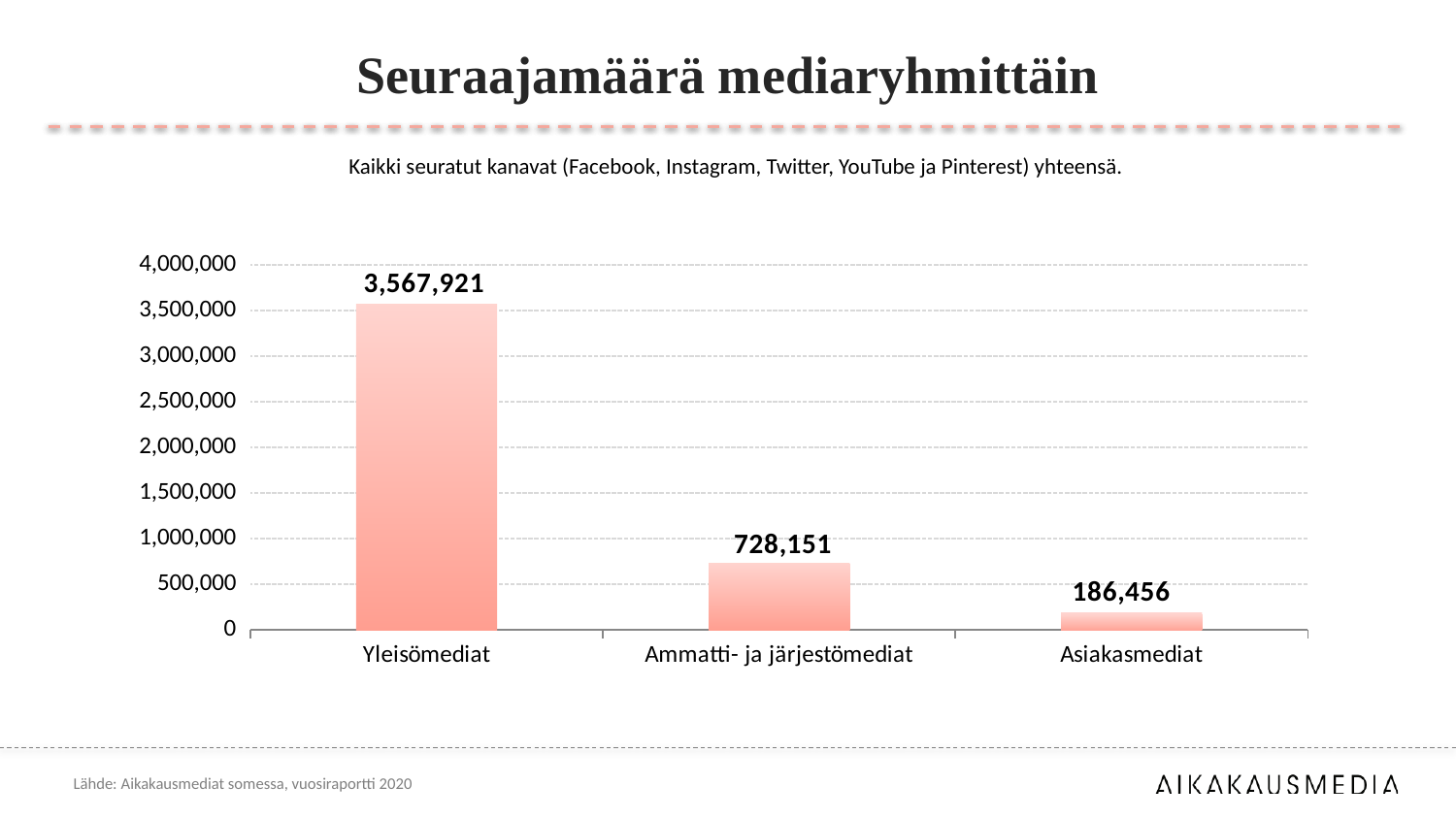
What is the title of the chart? Seuraajamäärä mediaryhmittäin What is the value for Yleisömediat? 3,567,921 What is the difference between the values for Ammatti- ja järjestömediat and Asiakasmediat? 541,695 What kind of chart is shown on the slide? bar chart How many categories are shown on the x axis? 3 Is the value for Ammatti- ja järjestömediat greater or less than 1,000,000? less Which category has the lowest value? Asiakasmediat What is the value for Asiakasmediat? 186,456 What is the value for Ammatti- ja järjestömediat? 728,151 Which is larger, the value for Ammatti- ja järjestömediat or the value for Asiakasmediat? Ammatti- ja järjestömediat What is the difference between the values for Yleisömediat and Ammatti- ja järjestömediat? 2,839,770 Which category has the highest value? Yleisömediat